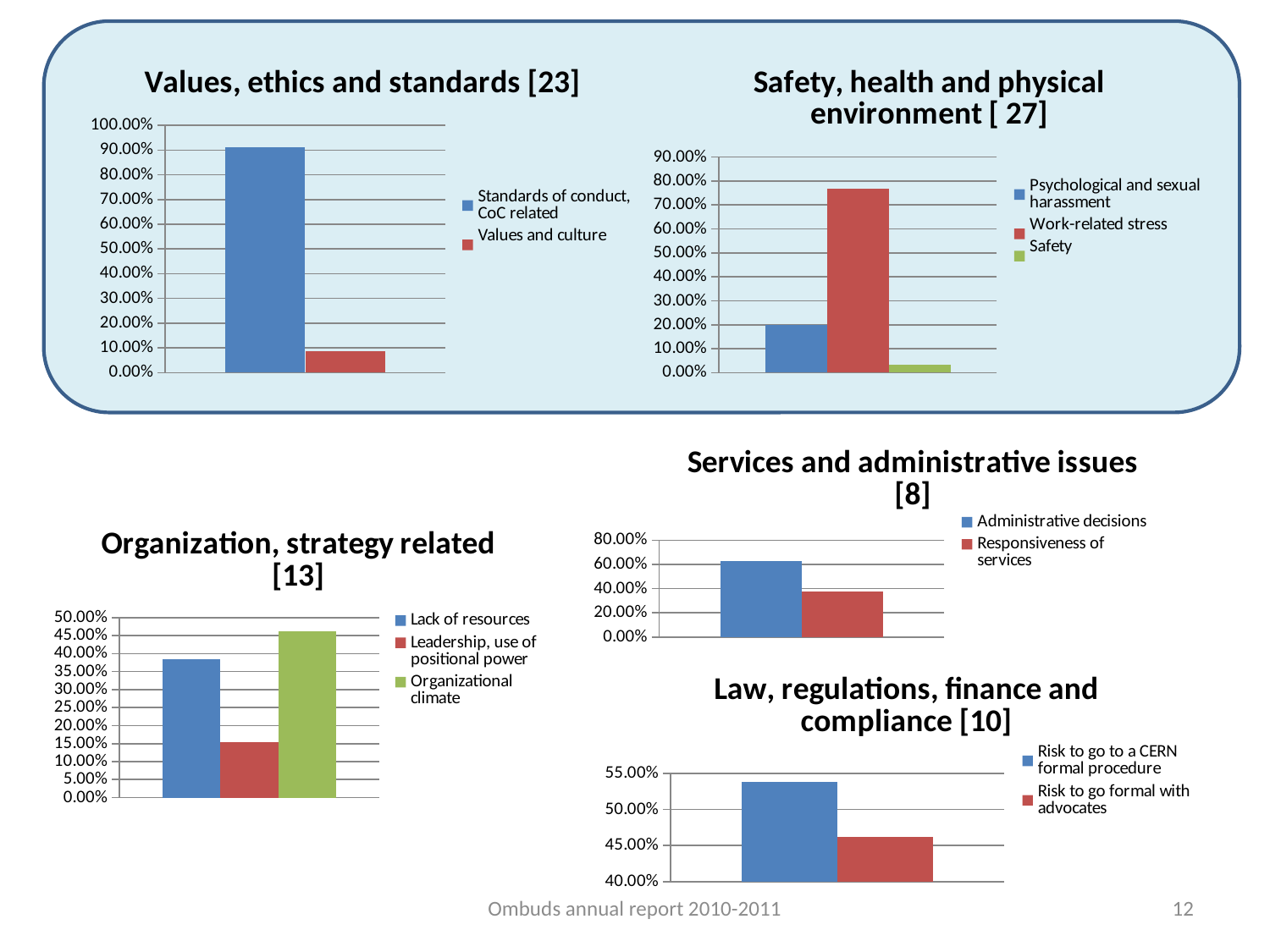
In the 'Services and administrative issues [8]' chart, which is larger: Administrative decisions or Responsiveness of services? Administrative decisions How many series does the legend of the 'Organization, strategy related [13]' chart list? 3 In the 'Safety, health and physical environment [ 27]' chart, which series has the lowest value? Safety In the 'Services and administrative issues [8]' chart, is the value for Administrative decisions greater or less than 40.00%? greater In the 'Safety, health and physical environment [ 27]' chart, is the value for Psychological and sexual harassment greater or less than 30.00%? less In the 'Organization, strategy related [13]' chart, which series has the highest value? Organizational climate What kind of chart is the 'Values, ethics and standards [23]' chart? bar chart In the 'Values, ethics and standards [23]' chart, which series has the highest value? Standards of conduct, CoC related In the 'Safety, health and physical environment [ 27]' chart, which series has the highest value? Work-related stress In the 'Values, ethics and standards [23]' chart, is the value for Standards of conduct, CoC related greater or less than 80.00%? greater In the 'Organization, strategy related [13]' chart, which series has the lowest value? Leadership, use of positional power